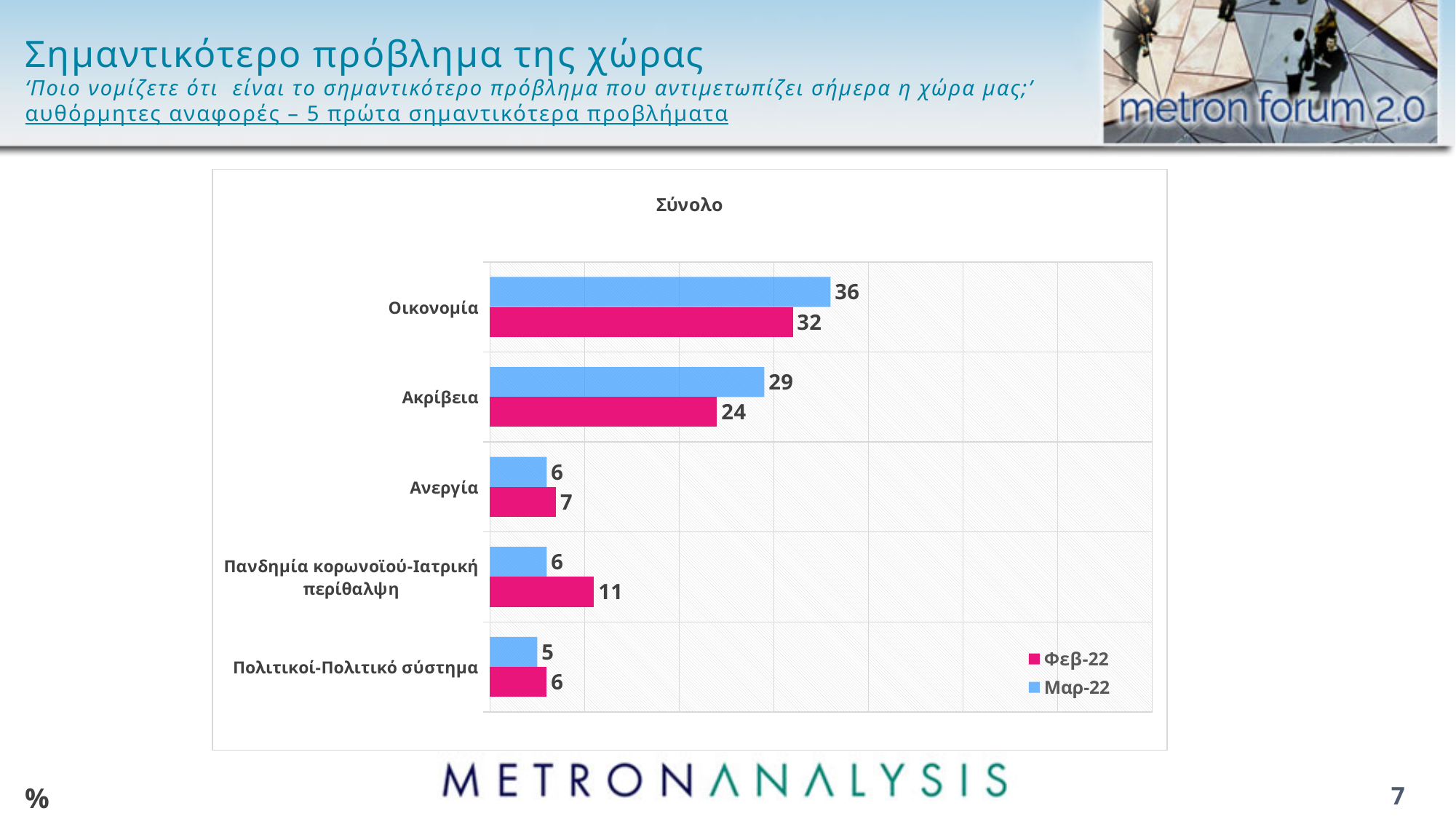
What is the difference between the Φεβ-22 and Μαρ-22 values for Πανδημία κορωνοϊού-Ιατρική περίθαλψη? 5 Which is larger for Οικονομία: the Φεβ-22 value or the Μαρ-22 value? Μαρ-22 How many categories are shown on the chart? 5 What is the difference between the Μαρ-22 and Φεβ-22 values for Ακρίβεια? 5 What is the title of the chart? Σύνολο What is the value for Πανδημία κορωνοϊού-Ιατρική περίθαλψη in the Φεβ-22 series? 11 Which category has the lowest value in the Μαρ-22 series? Πολιτικοί-Πολιτικό σύστημα What is the value for Ακρίβεια in the Φεβ-22 series? 24 What is the value for Οικονομία in the Μαρ-22 series? 36 What kind of chart is shown on the slide? Bar chart Which category has the highest value in the Μαρ-22 series? Οικονομία How many series does the legend list? 2